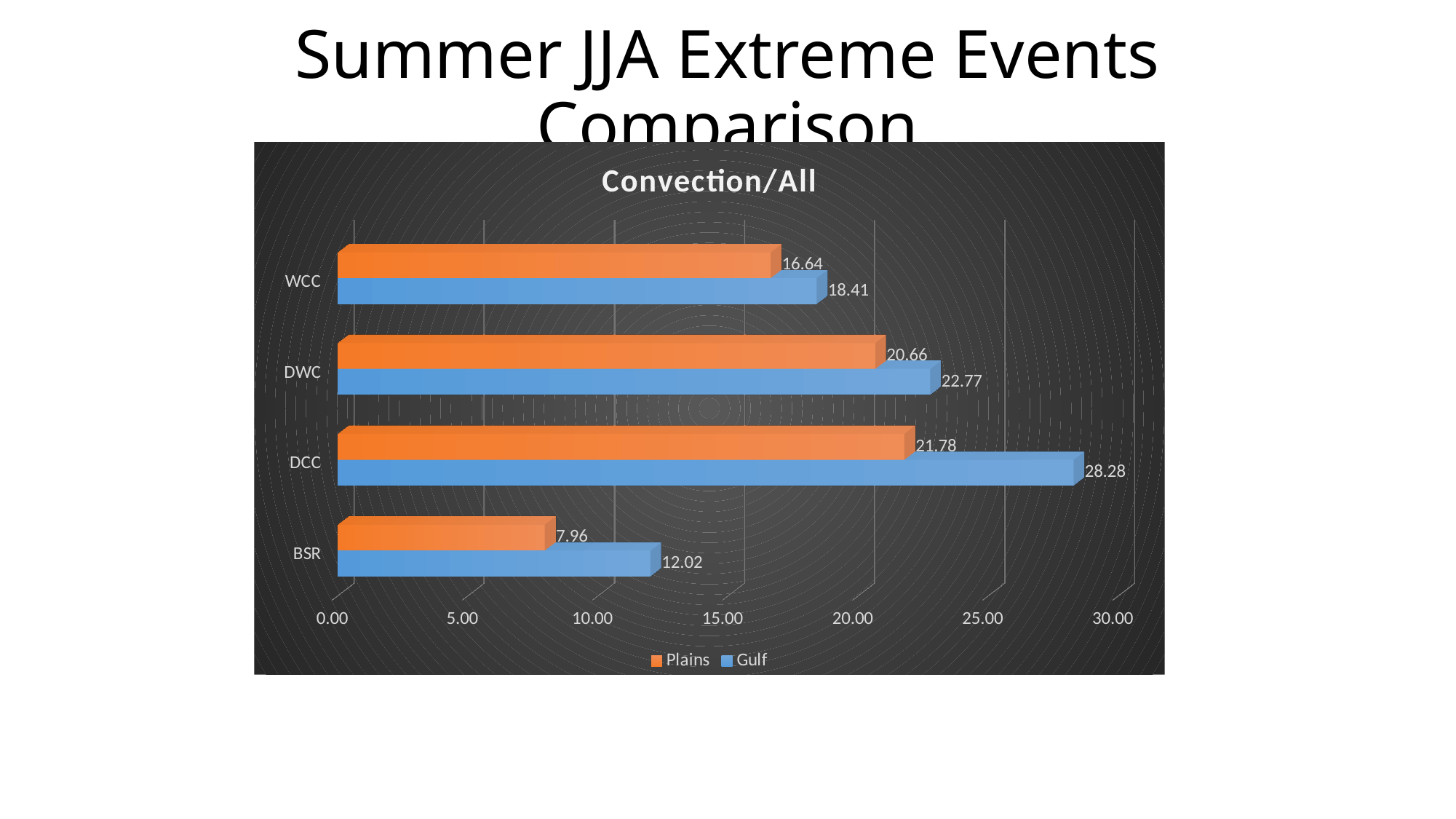
What is the Gulf value for WCC? 18.41 Which is larger for BSR, the Plains value or the Gulf value? Gulf What is the Plains value for DWC? 20.66 Which category has the highest Gulf value? DCC How many categories are shown on the chart? 4 What is the title of the chart? Convection/All What is the Gulf value for DCC? 28.28 What is the difference between the Gulf and Plains values for DCC? 6.50 Which category has the lowest Plains value? BSR What is the Plains value for BSR? 7.96 How many series does the legend list? 2 What kind of chart is shown on the slide? Bar chart